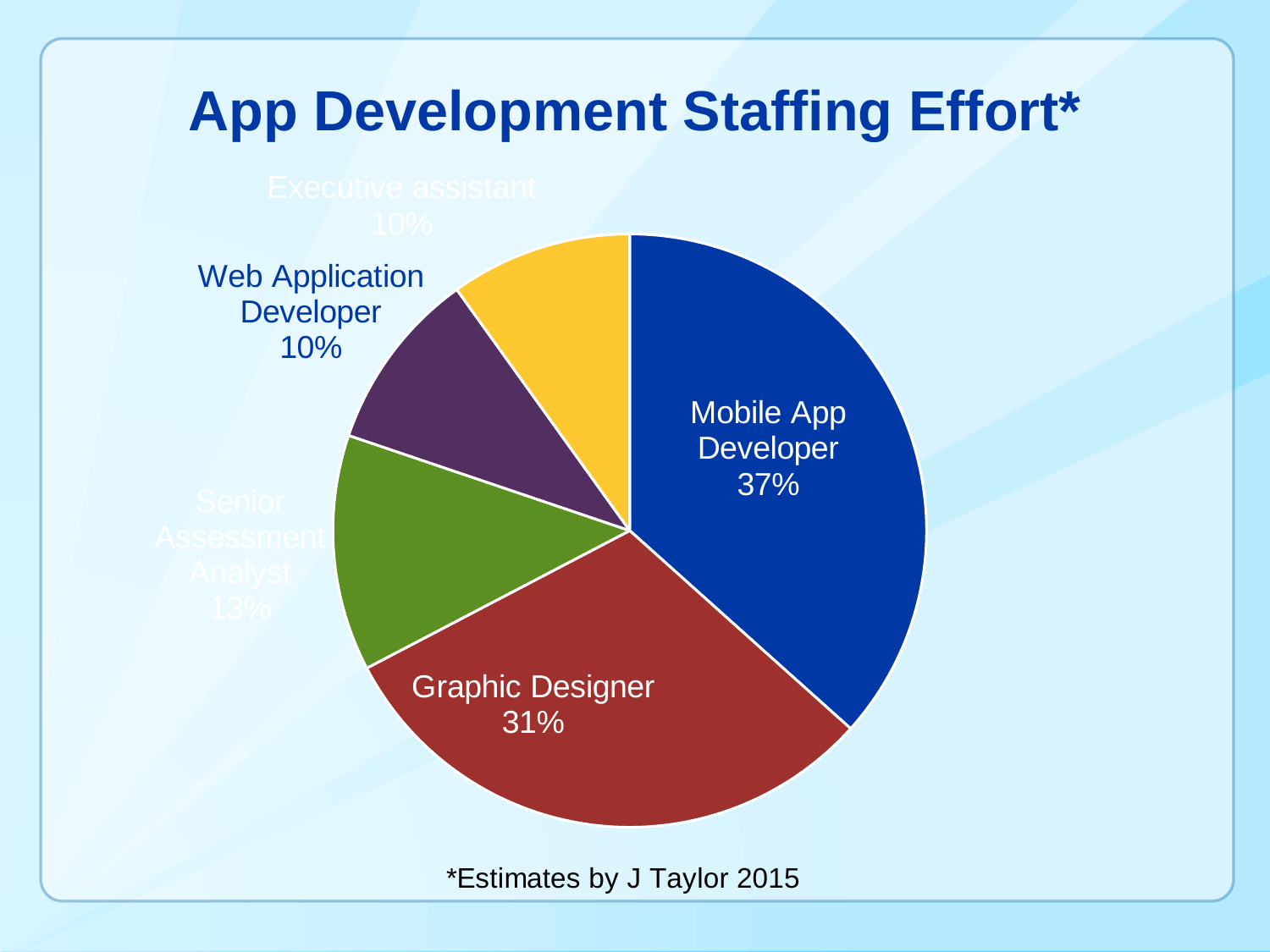
What is the title of the chart on the slide? App Development Staffing Effort* How many slices does the pie chart have? 5 What share of the staffing effort is attributed to Graphic Designer? 31% What kind of chart is shown on the slide? pie chart What percentage is shown for Senior Assessment Analyst? 13% Which is larger, the share for Mobile App Developer or the share for Graphic Designer? Mobile App Developer What percentage is shown for Web Application Developer? 10% What share of the staffing effort is attributed to Mobile App Developer? 37% Which role accounts for the largest share of the staffing effort? Mobile App Developer By how many percentage points does the Mobile App Developer share exceed the Graphic Designer share? 6 percentage points What colour is the Graphic Designer slice? red What percentage is shown for Executive assistant? 10%